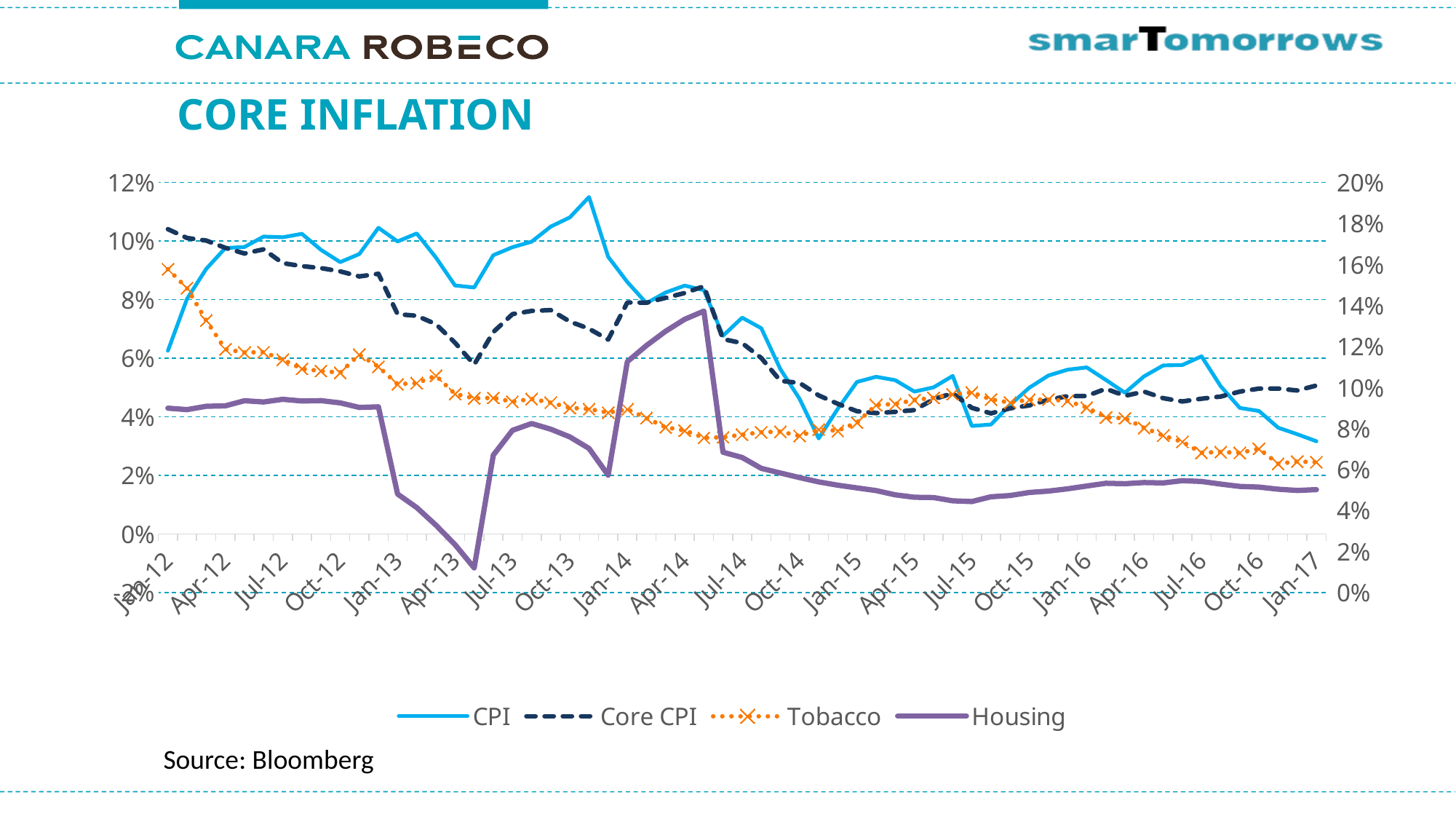
Which series is drawn as a dashed line? Core CPI How many date labels are shown on the x axis? 21 At Jan-12, which line is higher: CPI or Core CPI? Core CPI Is the value of the Core CPI line at Jan-12 greater or less than 8% on the left axis? greater At Jan-17, which line is higher: CPI or Core CPI? Core CPI How many series does the legend list? 4 Is the highest point of the CPI line greater or less than 10% on the left axis? greater What kind of chart is shown on the slide? line chart What is the title of the chart? CORE INFLATION Is the value of the CPI line at Jan-17 greater or less than 4% on the left axis? less Does the Housing line rise or fall overall from Jan-12 to Jan-17? fall Does the Tobacco line rise or fall overall from Jan-12 to Jan-17? fall